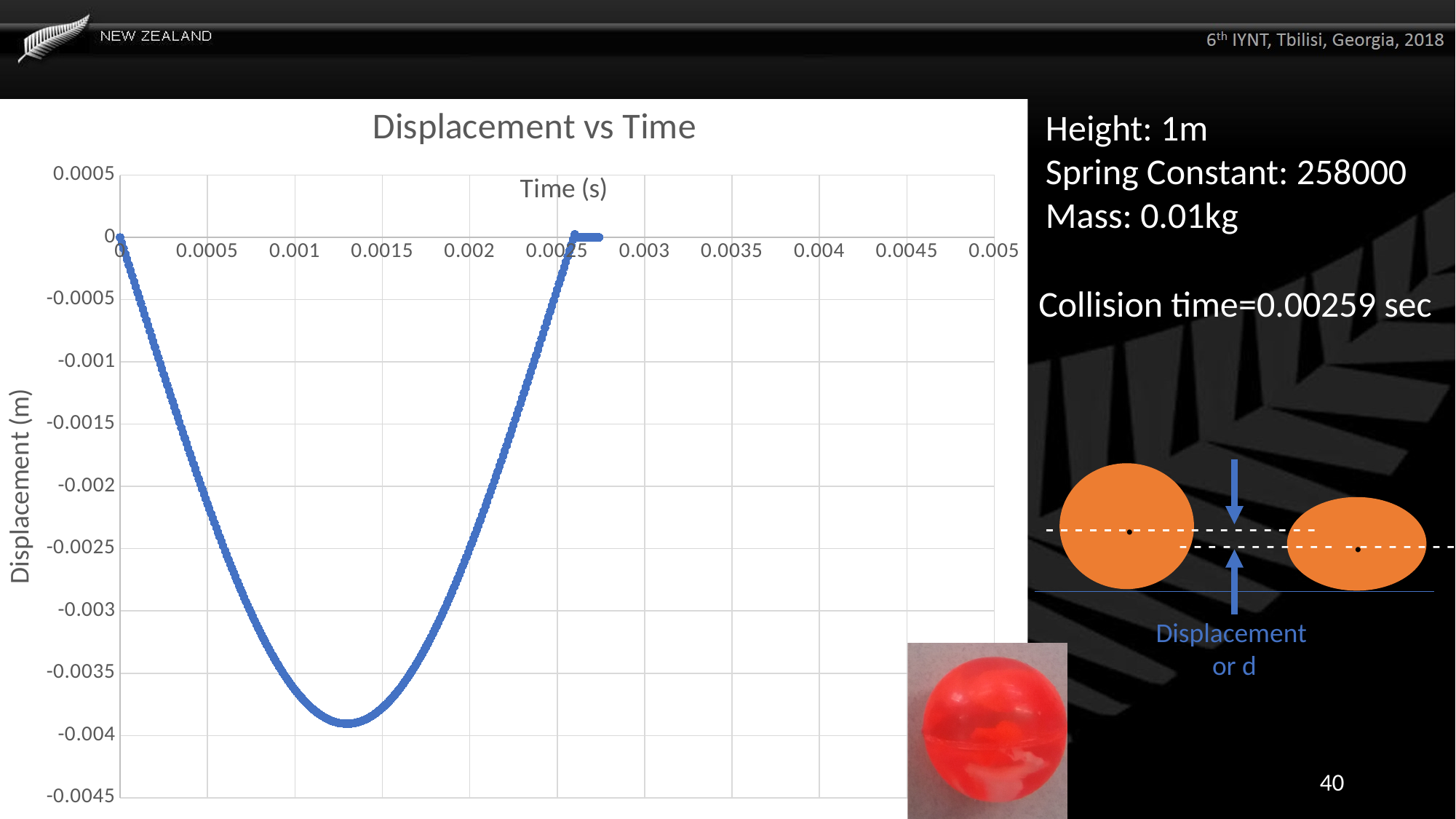
How does the displacement change along the time axis between 0 and about 0.0013 s? It falls What is the highest value shown on the vertical axis of the chart? 0.0005 Is the time at which the displacement reaches its minimum greater or less than 0.002 s? less What is the title of the chart? Displacement vs Time How many tick labels are shown on the horizontal (time) axis of the chart? 11 What is the displacement at time 0 on the chart? 0 What kind of chart is shown on the slide? Scatter (line) chart Is the minimum displacement reached on the chart greater or less than -0.004? greater Is the displacement at 0.0015 s greater or less than -0.003? less What is the label of the vertical axis of the chart? Displacement (m)